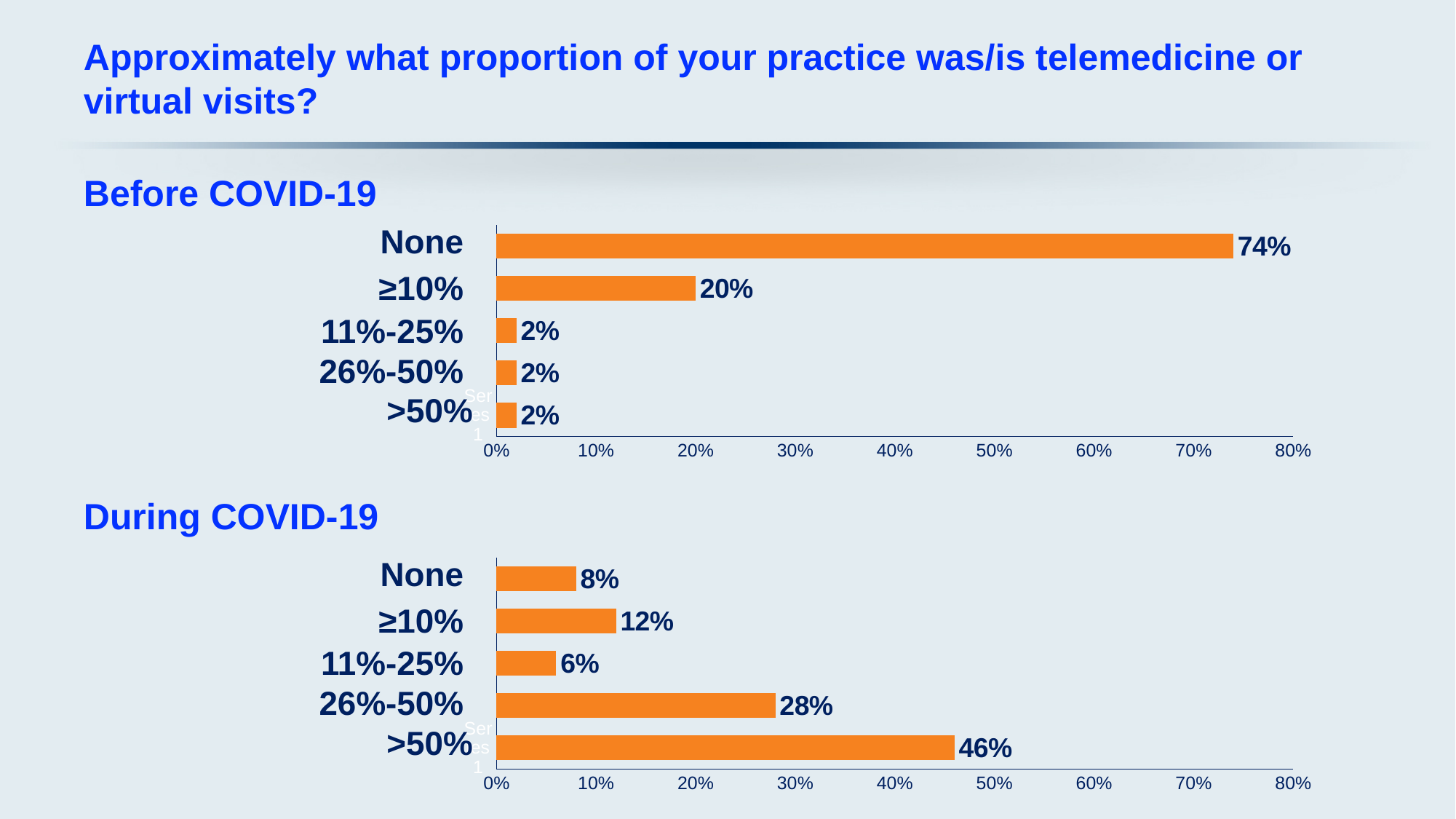
In the During COVID-19 chart, what is the value for >50%? 46% In the During COVID-19 chart, which is larger: the value for None or the value for ≥10%? ≥10% What colour are the bars in both charts? orange In the Before COVID-19 chart, is the value for ≥10% greater or less than 30%? less In the During COVID-19 chart, what is the value for 26%-50%? 28% In the Before COVID-19 chart, what is the difference between the None and ≥10% values? 54% In the During COVID-19 chart, which category has the lowest value? 11%-25% What type of chart is used for the Before COVID-19 data? bar chart In the Before COVID-19 chart, which category has the highest value? None In the Before COVID-19 chart, what percentage of respondents reported None? 74% How many categories are shown in the During COVID-19 chart? 5 In the During COVID-19 chart, what is the difference between the >50% and 26%-50% values? 18%